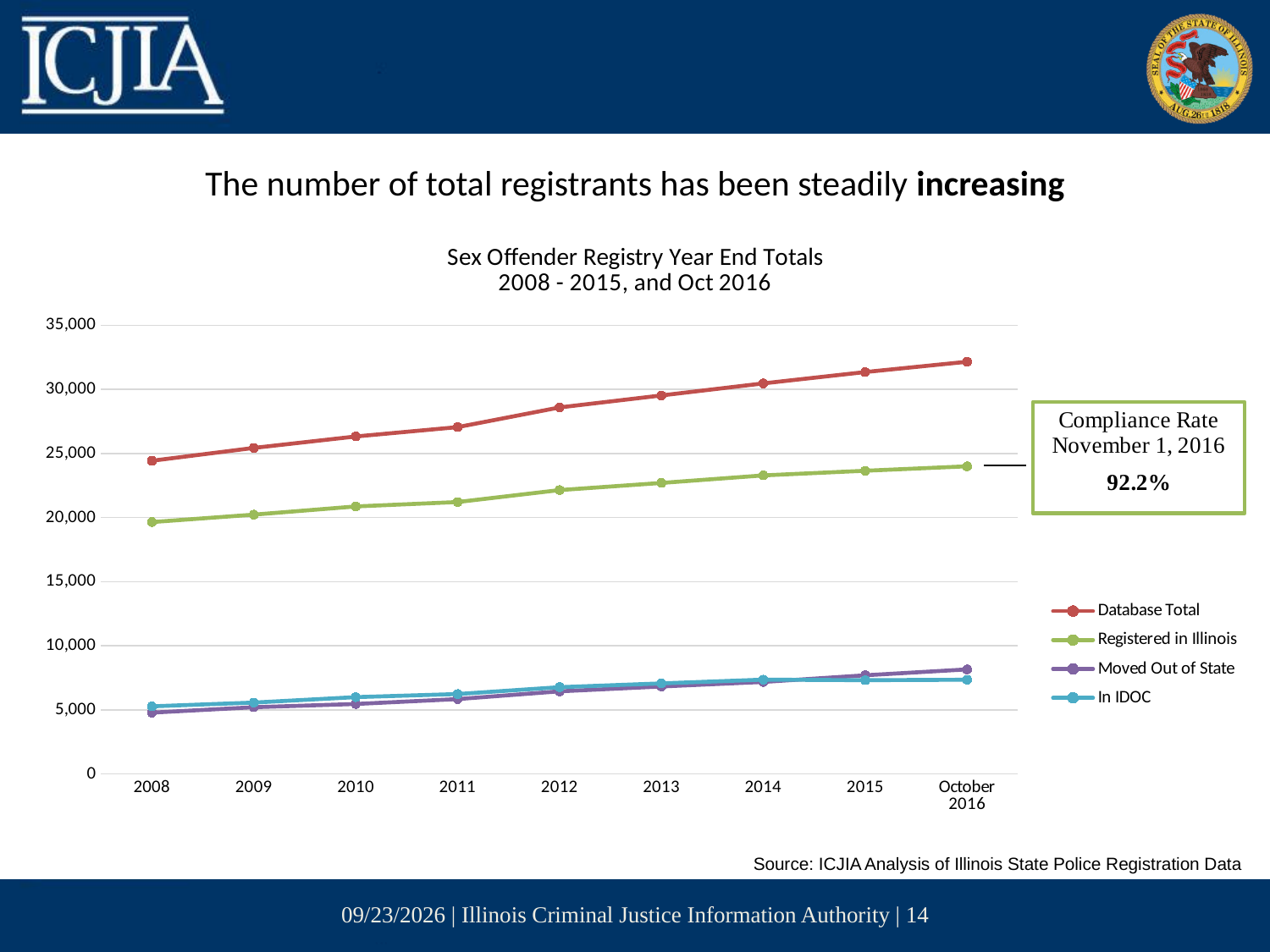
Does the Database Total series rise or fall from 2008 to October 2016? Rises What is the title of the chart? Sex Offender Registry Year End Totals 2008 - 2015, and Oct 2016 In October 2016, which is larger: Moved Out of State or In IDOC? Moved Out of State Is the Moved Out of State value for October 2016 greater or less than 10,000? less Which series has the highest values across all years? Database Total Is the Database Total value for 2008 greater or less than 25,000? less How many series does the chart legend list? 4 Is the Database Total value for October 2016 greater or less than 30,000? greater Which series has the lowest value in 2008? Moved Out of State What kind of chart is shown on the slide? Line chart What compliance rate is shown in the box next to the chart for November 1, 2016? 92.2% How many time points are plotted along the x axis? 9